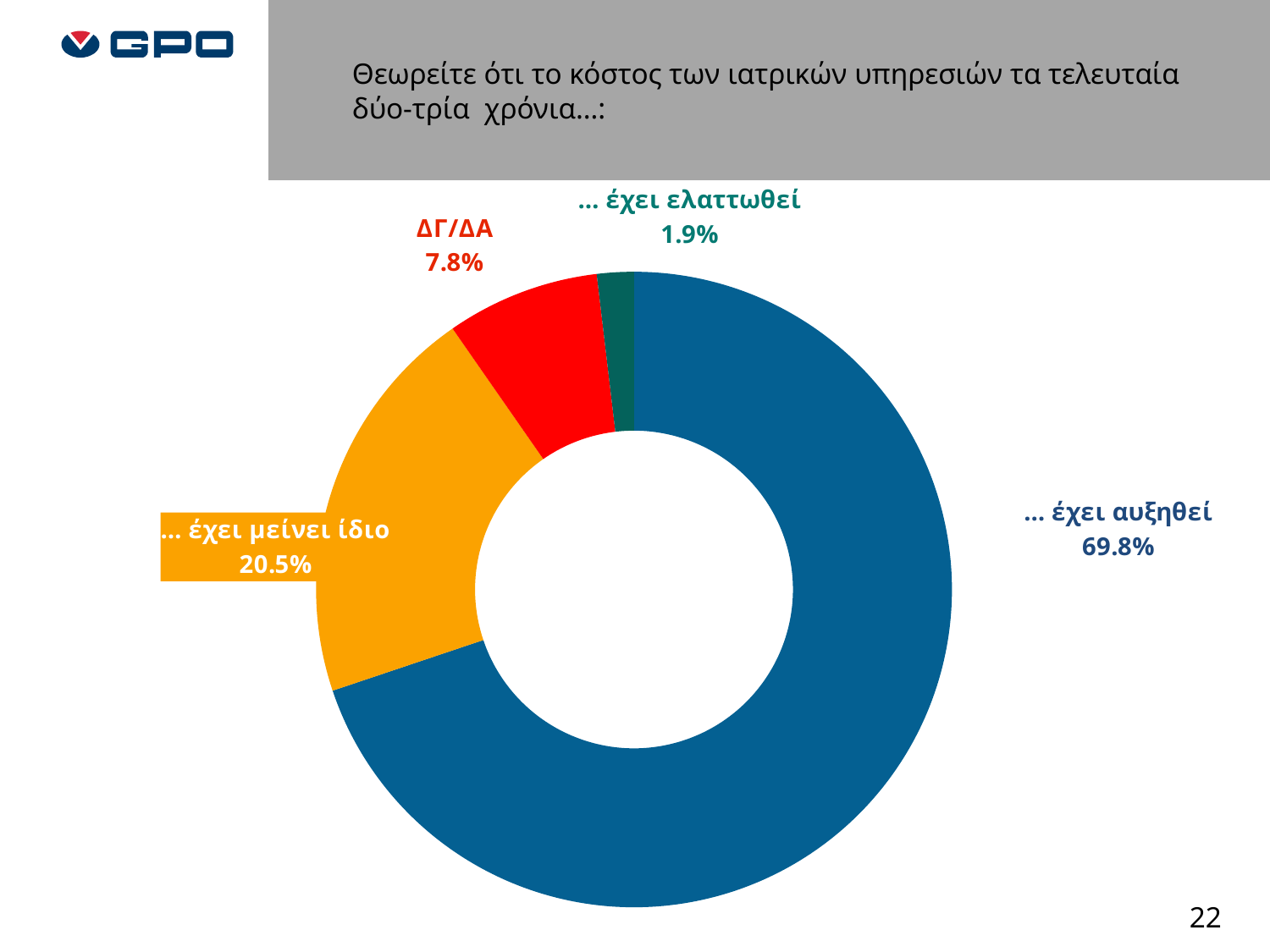
What percentage of respondents answered "… έχει ελαττωθεί"? 1.9% Which response has the largest share of the chart? … έχει αυξηθεί What kind of chart is shown on the slide? Doughnut (pie) chart What colour is the slice for "… έχει μείνει ίδιο"? Orange What is the difference in percentage points between "ΔΓ/ΔΑ" and "… έχει ελαττωθεί"? 5.9 percentage points What percentage is shown for "ΔΓ/ΔΑ"? 7.8% Which response has the smallest share of the chart? … έχει ελαττωθεί What percentage of respondents answered "… έχει μείνει ίδιο"? 20.5% Which is larger: the share for "ΔΓ/ΔΑ" or the share for "… έχει ελαττωθεί"? ΔΓ/ΔΑ What percentage of respondents answered "… έχει αυξηθεί"? 69.8% How many categories (slices) does the chart have? 4 What is the difference in percentage points between "… έχει αυξηθεί" and "… έχει μείνει ίδιο"? 49.3 percentage points